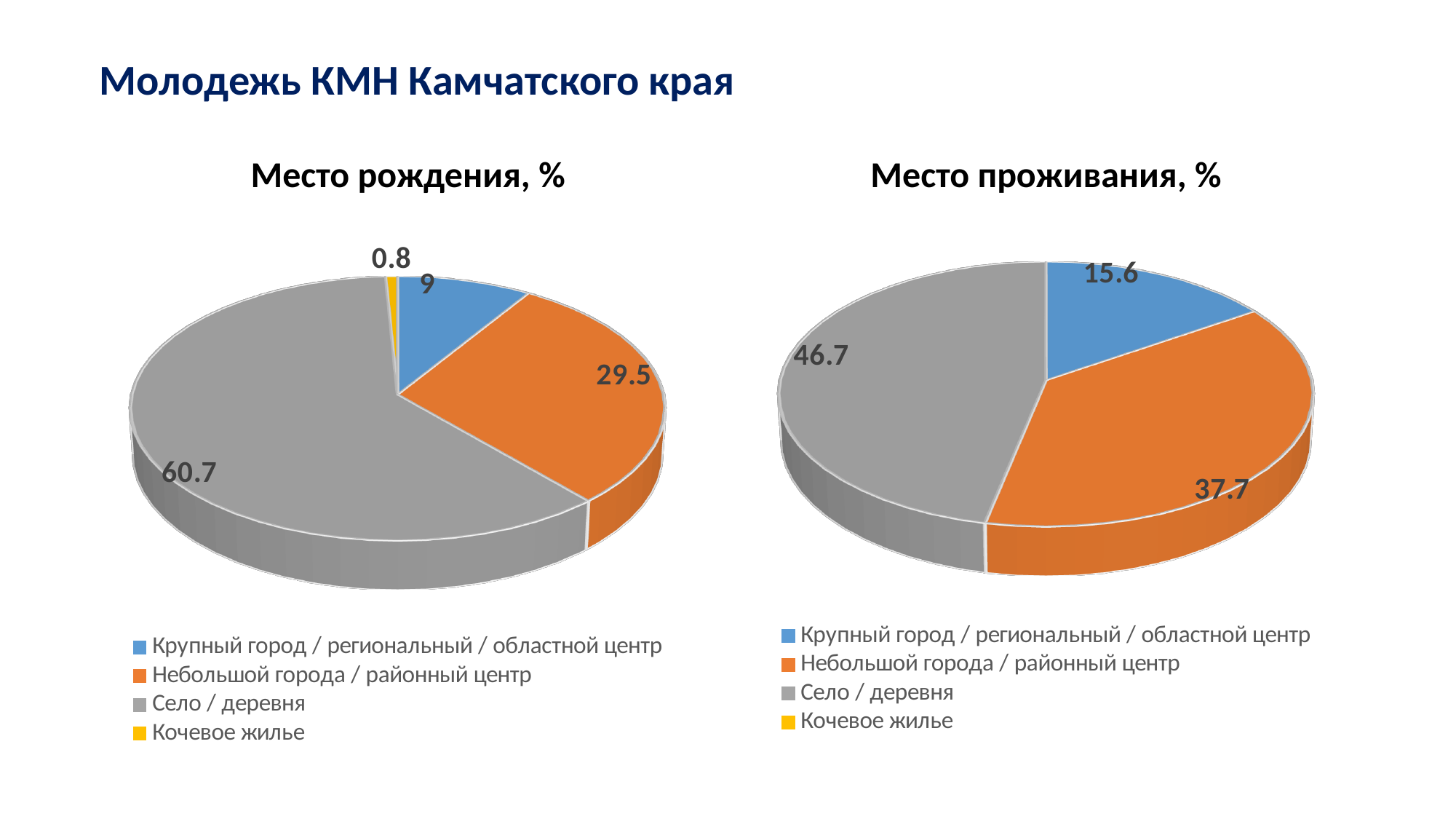
In the chart titled "Место рождения, %", what is the value for "Небольшой города / районный центр"? 29.5 In the chart titled "Место проживания, %", which category has the largest slice? Село / деревня How many entries does the legend of the chart titled "Место проживания, %" list? 4 In the chart titled "Место проживания, %", what is the value for "Крупный город / региональный / областной центр"? 15.6 What kind of chart is the chart titled "Место рождения, %"? Pie chart In the chart titled "Место рождения, %", which category has the smallest slice? Кочевое жилье In the chart titled "Место рождения, %", what is the value for "Кочевое жилье"? 0.8 In the chart titled "Место проживания, %", what is the value for "Небольшой города / районный центр"? 37.7 In the chart titled "Место проживания, %", what is the difference between the values for "Село / деревня" and "Крупный город / региональный / областной центр"? 31.1 In the chart titled "Место рождения, %", what is the value for "Село / деревня"? 60.7 In the chart titled "Место рождения, %", what is the difference between the values for "Село / деревня" and "Небольшой города / районный центр"? 31.2 Which is larger: the value for "Крупный город / региональный / областной центр" in the "Место рождения, %" chart or in the "Место проживания, %" chart? Место проживания, %